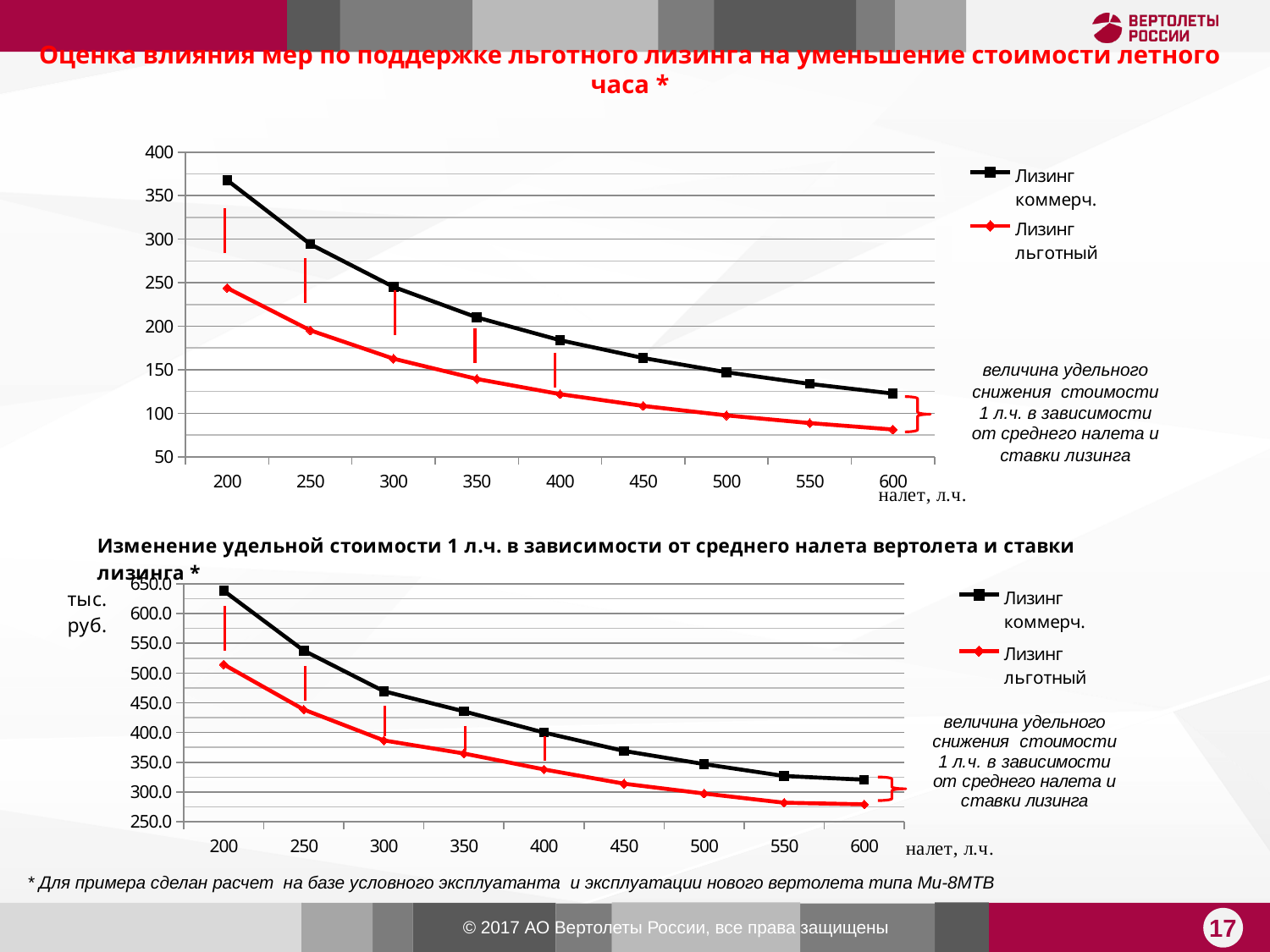
In the top chart, is the value of 'Лизинг коммерч.' at налет 400 greater or less than 200? less In the bottom chart, is the value of 'Лизинг коммерч.' at налет 200 greater or less than 600.0? greater In the bottom chart, is the value of 'Лизинг льготный' at налет 600 greater or less than 300.0? less In the top chart, which series is higher at налет 300: 'Лизинг коммерч.' or 'Лизинг льготный'? Лизинг коммерч. In the bottom chart, what colour is the line for the 'Лизинг льготный' series? red In the top chart, do the values of the 'Лизинг коммерч.' series rise or fall as налет increases from 200 to 600? fall How many data points does each series in the bottom chart have? 9 How many series does the legend of the top chart list? 2 What kind of chart is the top chart on the slide? line chart